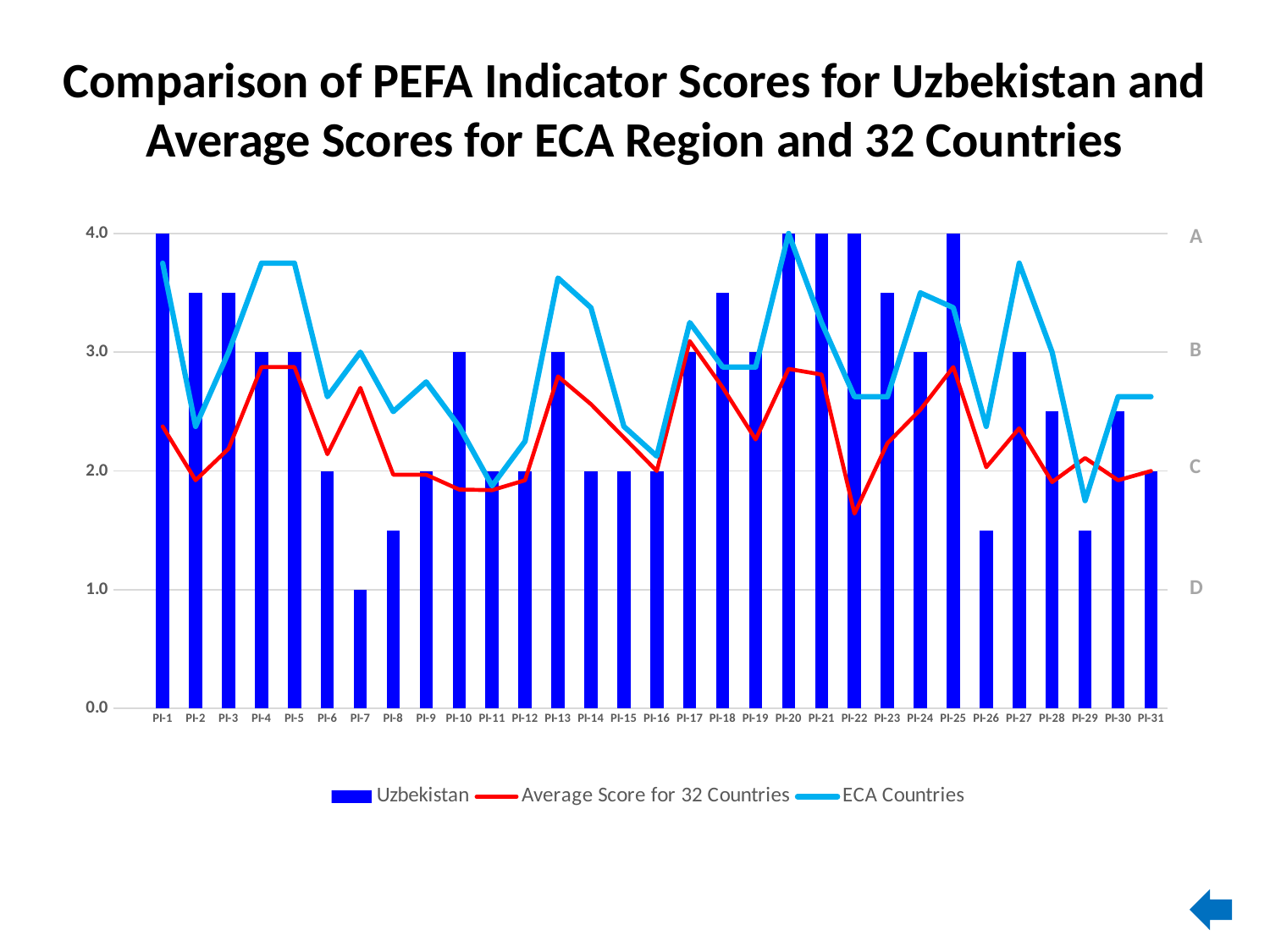
What is the Uzbekistan score for PI-1? 4.0 How many indicators (PI categories) are shown on the x axis? 31 Which indicator has the lowest Uzbekistan score? PI-7 Is the Uzbekistan score for PI-2 greater or less than 3.0? greater What is the Uzbekistan score for PI-7? 1.0 Which series is shown as blue bars? Uzbekistan What colour is the line for ECA Countries? Light blue What kind of chart is this? A combined bar and line chart Is the Uzbekistan score for PI-26 greater or less than 2.0? less How many series does the legend list? 3 What is the difference between the Uzbekistan scores for PI-1 and PI-7? 3.0 Which has the higher Uzbekistan score, PI-10 or PI-8? PI-10